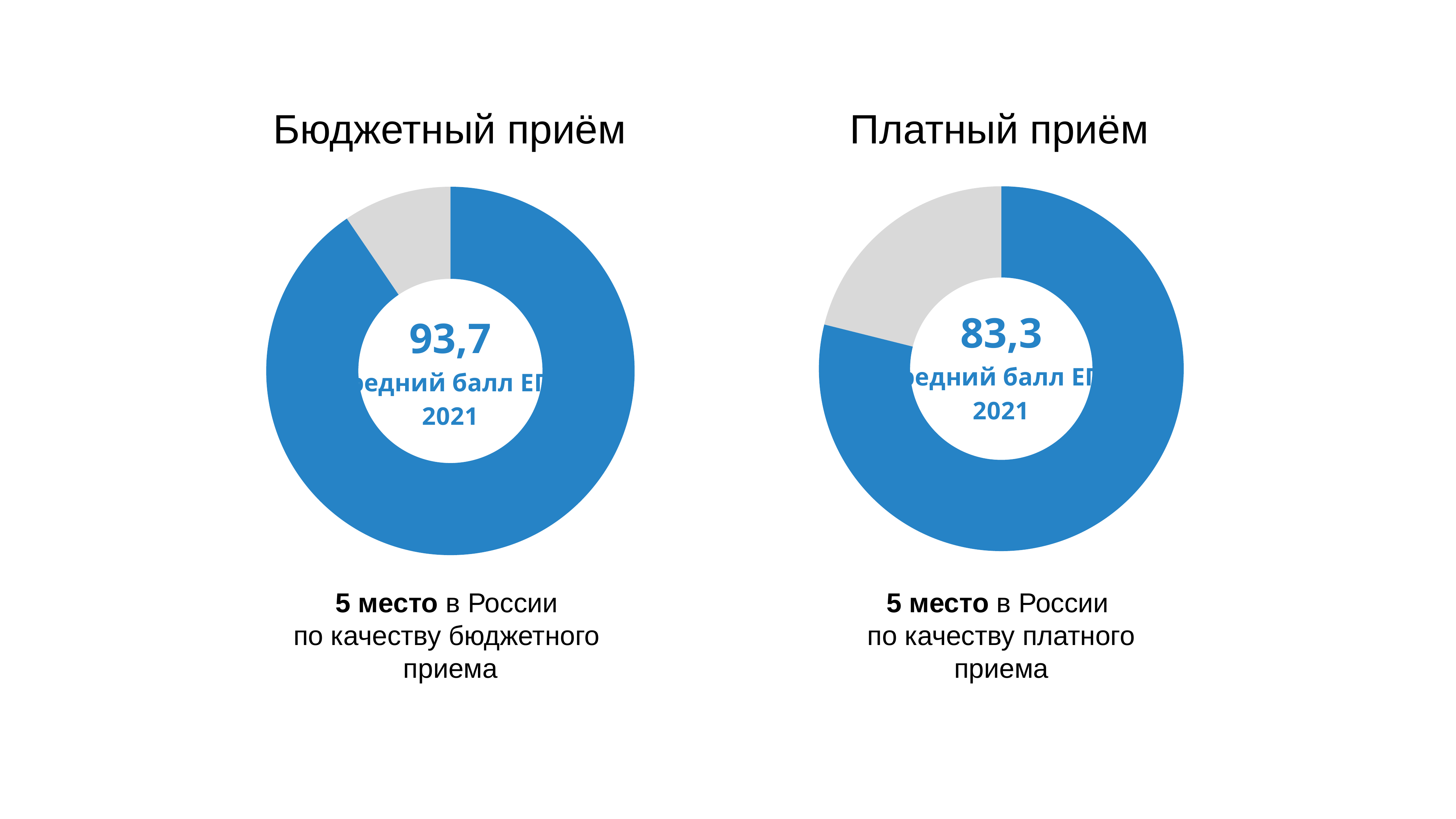
On the 'Платный приём' chart, what value is shown in the centre of the donut? 83,3 What is the title of the chart on the right side of the slide? Платный приём On the 'Бюджетный приём' chart, which slice is larger: the blue one or the grey one? Blue Which chart shows the higher average score: 'Бюджетный приём' or 'Платный приём'? Бюджетный приём On the 'Платный приём' chart, which slice is smaller: the blue one or the grey one? Grey What kind of chart is used on the left side of the slide under 'Бюджетный приём'? Donut (pie) chart What year is referenced in the centre label of both donut charts? 2021 Which chart has the larger grey slice: 'Бюджетный приём' or 'Платный приём'? Платный приём What is the difference between the centre values of the 'Бюджетный приём' chart (93,7) and the 'Платный приём' chart (83,3)? 10,4 On the 'Бюджетный приём' chart, what value is shown in the centre of the donut? 93,7 How many slices does the 'Платный приём' donut chart have? 2